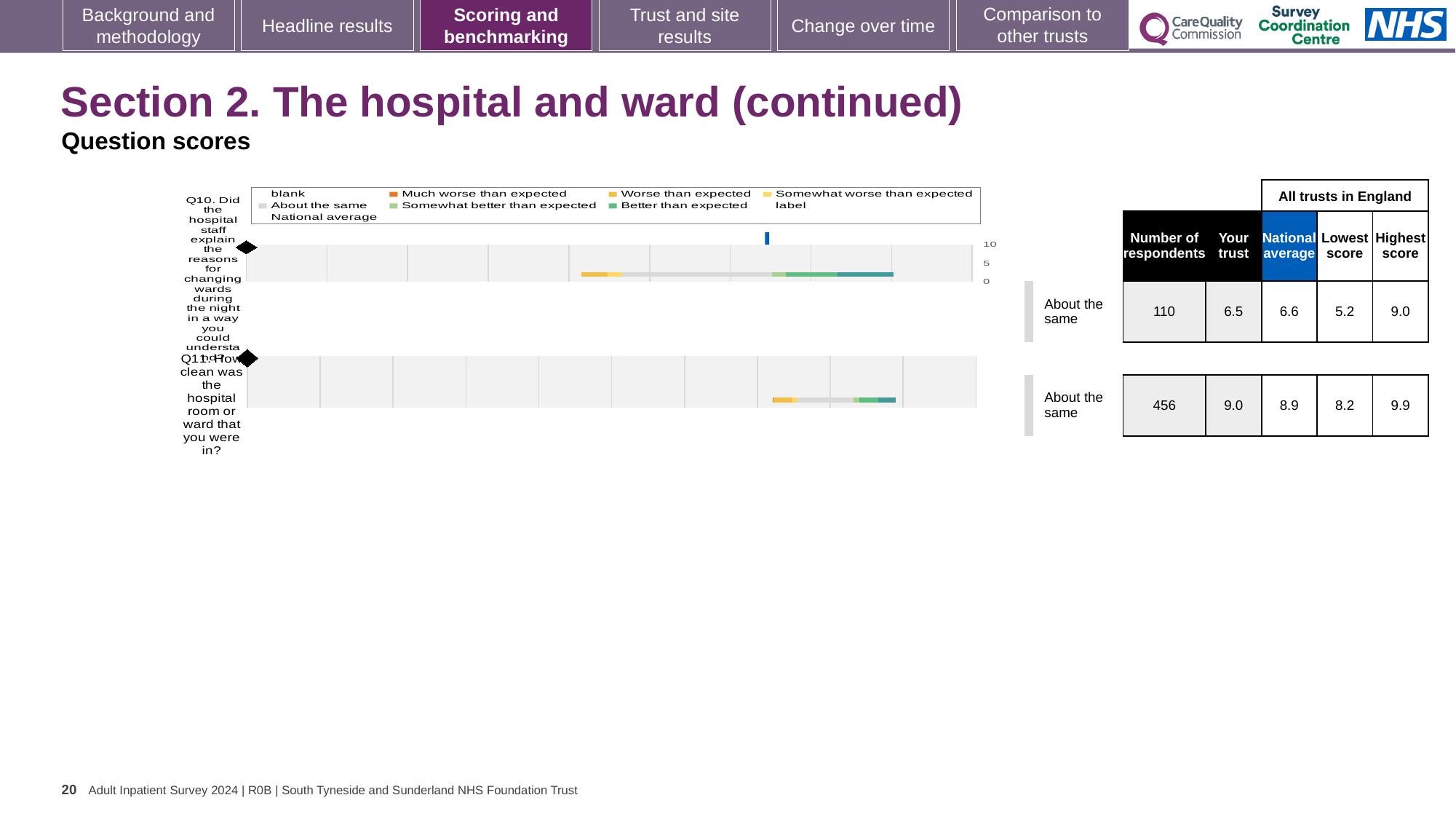
What kind of chart is used to show the question scores on this slide? Bar chart How many questions (Q10 and Q11) are plotted on the chart? 2 Which benchmark category does the trust's Q10 score fall into? About the same Is the trust's score for Q11 greater or less than 5 on the chart axis? greater How many respondents answered Q11? 456 What is the highest tick value shown on the chart's score axis? 10 What is the difference between the highest score and the lowest score for Q11? 1.7 What is the difference between the highest score and the lowest score for Q10? 3.8 What is the national average score for Q10? 6.6 What is the 'Your trust' score for Q10 (explaining reasons for changing wards during the night)? 6.5 What is the 'Your trust' score for Q11 (how clean was the hospital room or ward)? 9.0 For Q11, which is larger: the 'Your trust' score or the national average? Your trust